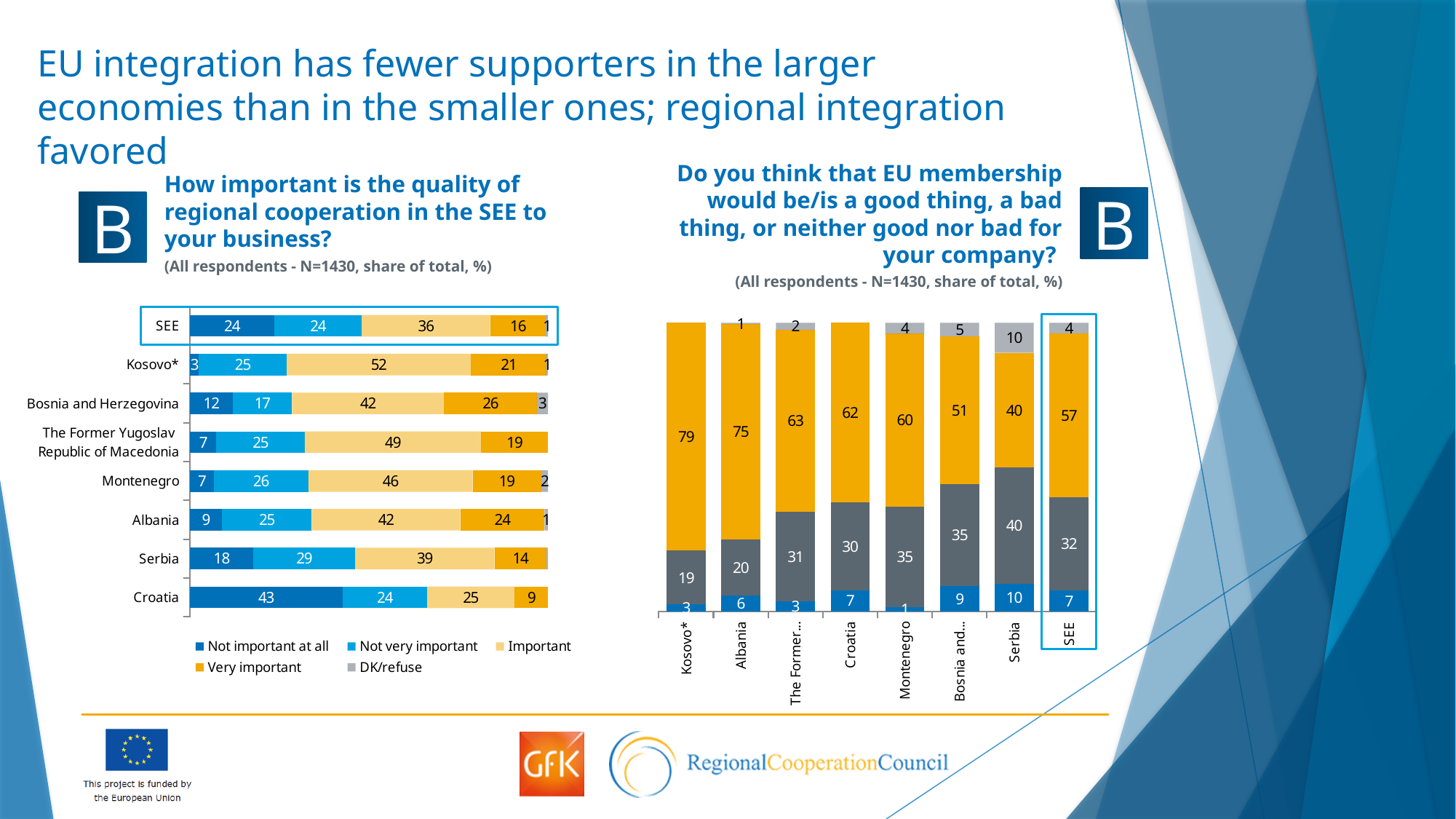
In the left chart on regional cooperation, what is the 'Important' value for Kosovo*? 52 In the left chart on regional cooperation, what is the difference between the 'Very important' values for Bosnia and Herzegovina and Serbia? 12 In the right chart on EU membership, is the orange segment for Croatia larger or smaller than the orange segment for Serbia? Larger In the left chart on regional cooperation, what kind of chart is shown? Stacked bar chart In the right chart on EU membership, what is the value of the orange segment for Kosovo*? 79 In the left chart on regional cooperation, which category has the highest 'Not important at all' value? Croatia In the left chart on regional cooperation, what share of respondents in Croatia said it is 'Not important at all'? 43 In the right chart on EU membership, how many categories are shown on the x axis? 8 In the right chart on EU membership, which category has the largest grey (top) segment? Serbia In the left chart on regional cooperation, which category has the lowest 'Very important' value? Croatia In the right chart on EU membership, what is the difference between the orange segment values for Albania and Montenegro? 15 In the left chart on regional cooperation, how many series does the legend list? 5